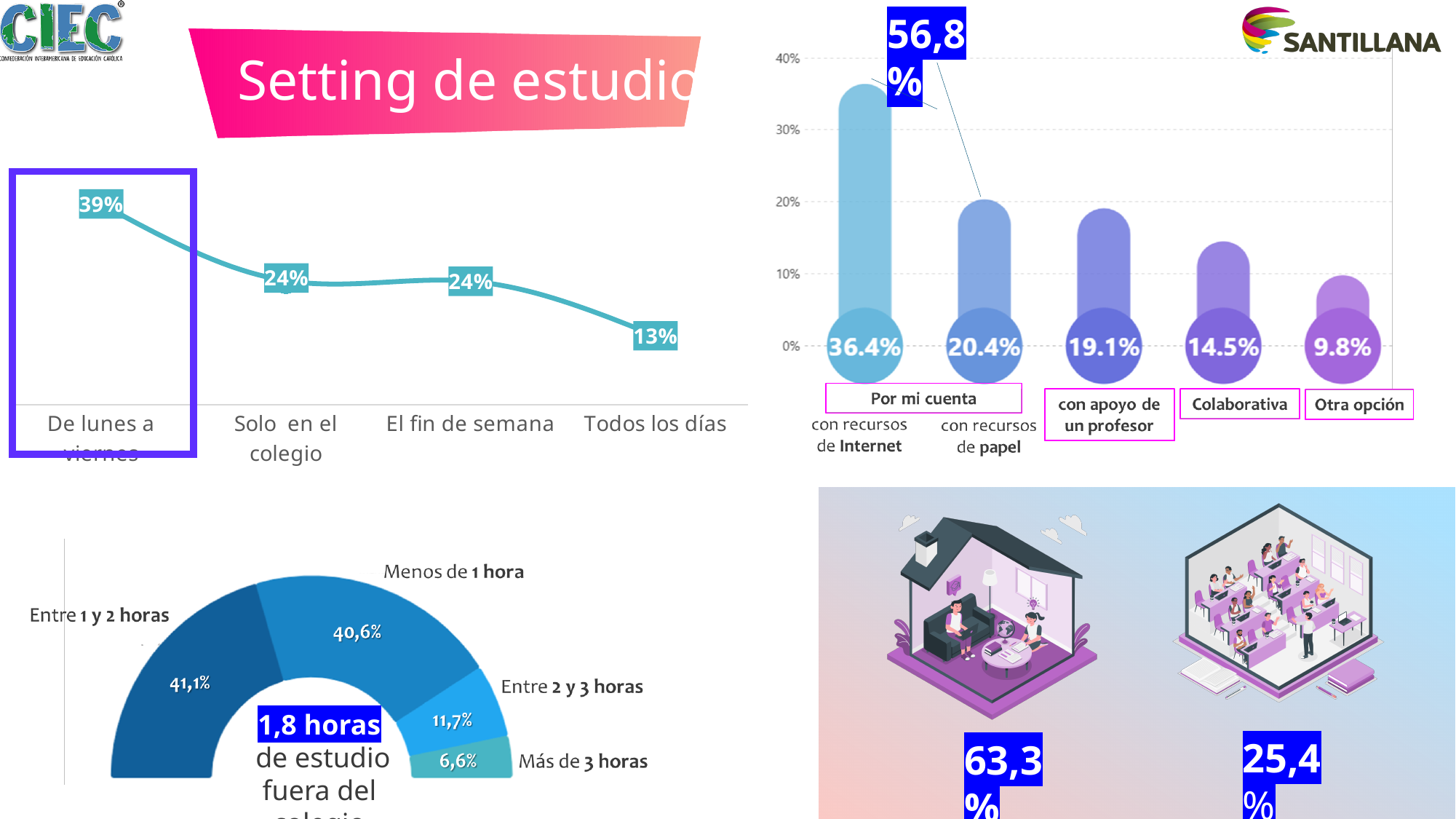
In the bar chart at the top right, how many bars are plotted? 5 In the line chart at the top left, what is the value for 'Todos los días'? 13% In the line chart at the top left, which category has the highest value? De lunes a viernes In the bar chart at the top right, what is the value for 'Colaborativa'? 14.5% In the bar chart at the top right, which category has the lowest value? Otra opción In the line chart at the top left, what is the value for 'De lunes a viernes'? 39% In the line chart at the top left, do the values rise or fall from left to right along the x axis? fall In the semicircle chart at the bottom left, what is the share for 'Entre 2 y 3 horas'? 11,7% In the bar chart at the top right, which is larger: 'con recursos de papel' or 'Colaborativa'? con recursos de papel In the bar chart at the top right, what is the value for 'con apoyo de un profesor'? 19.1% In the line chart at the top left, what is the difference between 'De lunes a viernes' and 'Todos los días'? 26% In the semicircle chart at the bottom left, which segment has the smallest share? Más de 3 horas